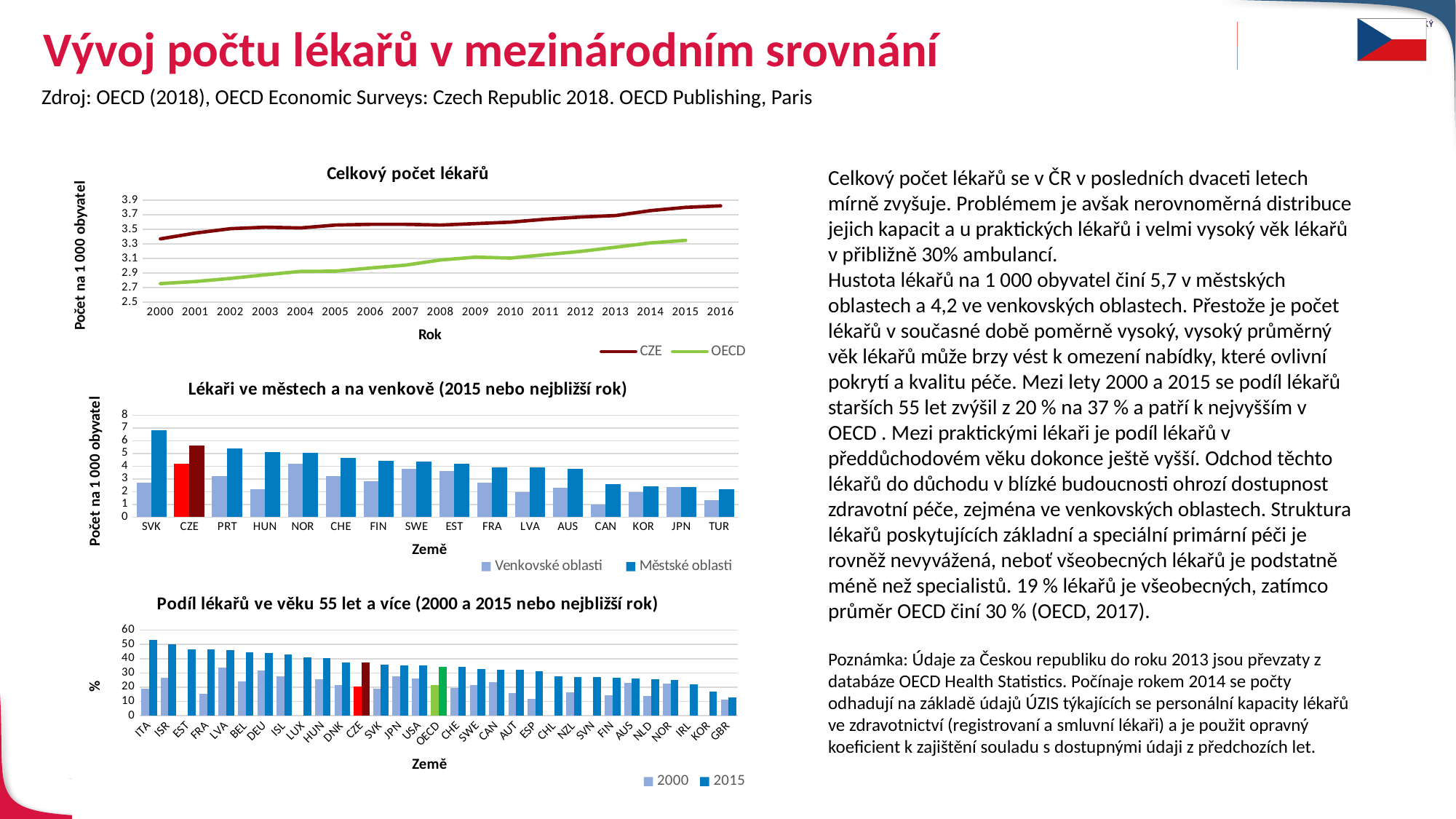
In the 'Celkový počet lékařů' chart, is the CZE value for 2016 greater or less than 3.7? greater In the 'Lékaři ve městech a na venkově' chart, which country has the lowest value for Venkovské oblasti? CAN In the 'Lékaři ve městech a na venkově' chart, is the Městské oblasti value for CZE greater or less than 5? greater In the 'Lékaři ve městech a na venkově' chart, which country has the highest value for Městské oblasti? SVK In the 'Podíl lékařů ve věku 55 let a více' chart, which country has the highest value for 2015? ITA In the 'Celkový počet lékařů' chart, how many series does the legend list? 2 In the 'Celkový počet lékařů' chart, is the OECD value for 2000 greater or less than 2.9? less In the 'Celkový počet lékařů' chart, how many years are shown on the x axis? 17 What kind of chart is 'Lékaři ve městech a na venkově (2015 nebo nejbližší rok)'? bar chart In the 'Podíl lékařů ve věku 55 let a více' chart, is the 2015 value for CZE larger or smaller than its 2000 value? larger What kind of chart is the 'Celkový počet lékařů' chart? line chart In the 'Celkový počet lékařů' chart, does the CZE line rise or fall from 2000 to 2016? rise